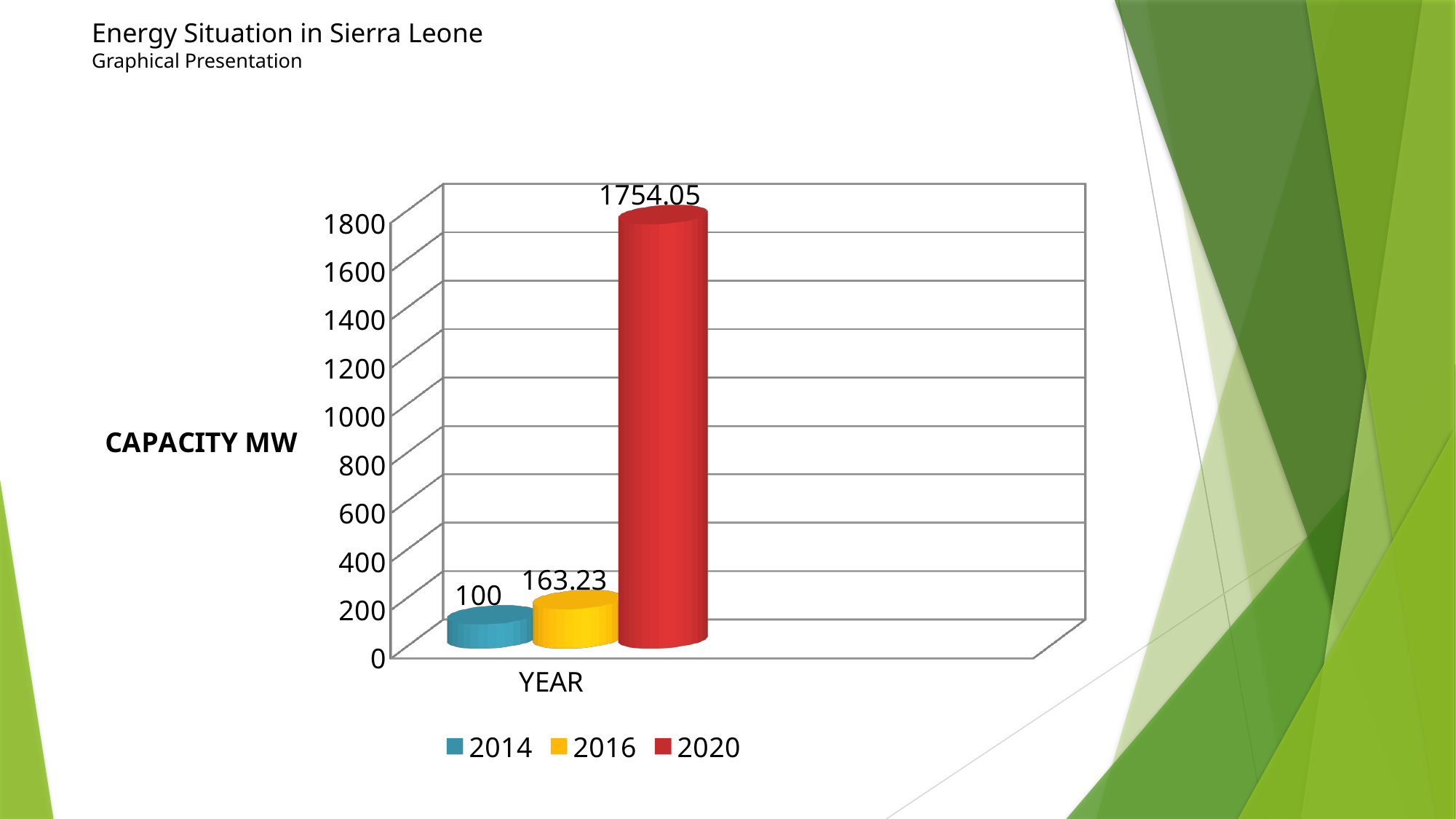
What kind of chart is shown on the slide? bar chart What is the label on the vertical axis of the chart? CAPACITY MW What is the capacity in MW for 2020? 1754.05 Which year has the lowest capacity? 2014 What is the capacity in MW for 2014? 100 Which year has the highest capacity? 2020 What is the difference in capacity between 2016 and 2014? 63.23 What is the difference in capacity between 2020 and 2016? 1590.82 Which is larger, the capacity for 2016 or for 2014? 2016 What is the capacity in MW for 2016? 163.23 Is the value for 2020 greater or less than 1600? greater How many series does the legend list? 3